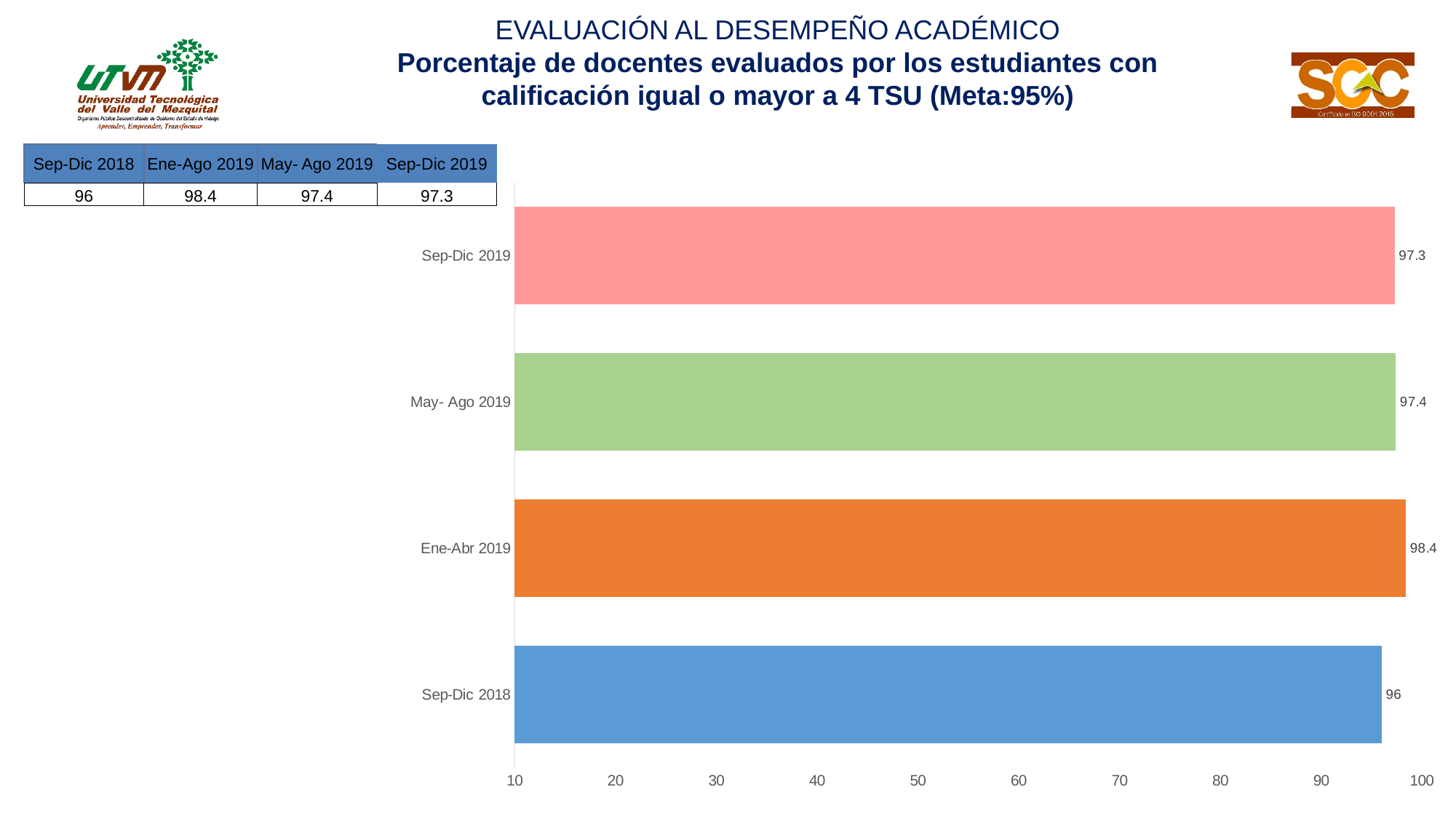
Is the value for Sep-Dic 2018 greater or less than 90? greater What is the value for May- Ago 2019? 97.4 Which is larger, the value for Ene-Abr 2019 or the value for Sep-Dic 2018? Ene-Abr 2019 Which period has the lowest value? Sep-Dic 2018 How many bars (categories) does the chart show? 4 What is the difference between the values for Ene-Abr 2019 and Sep-Dic 2018? 2.4 What target (Meta) is stated in the chart title? 95% What kind of chart is shown on the slide? bar chart Which period has the highest value? Ene-Abr 2019 What is the value for Sep-Dic 2019? 97.3 What is the value for Sep-Dic 2018? 96 What is the value for Ene-Abr 2019? 98.4